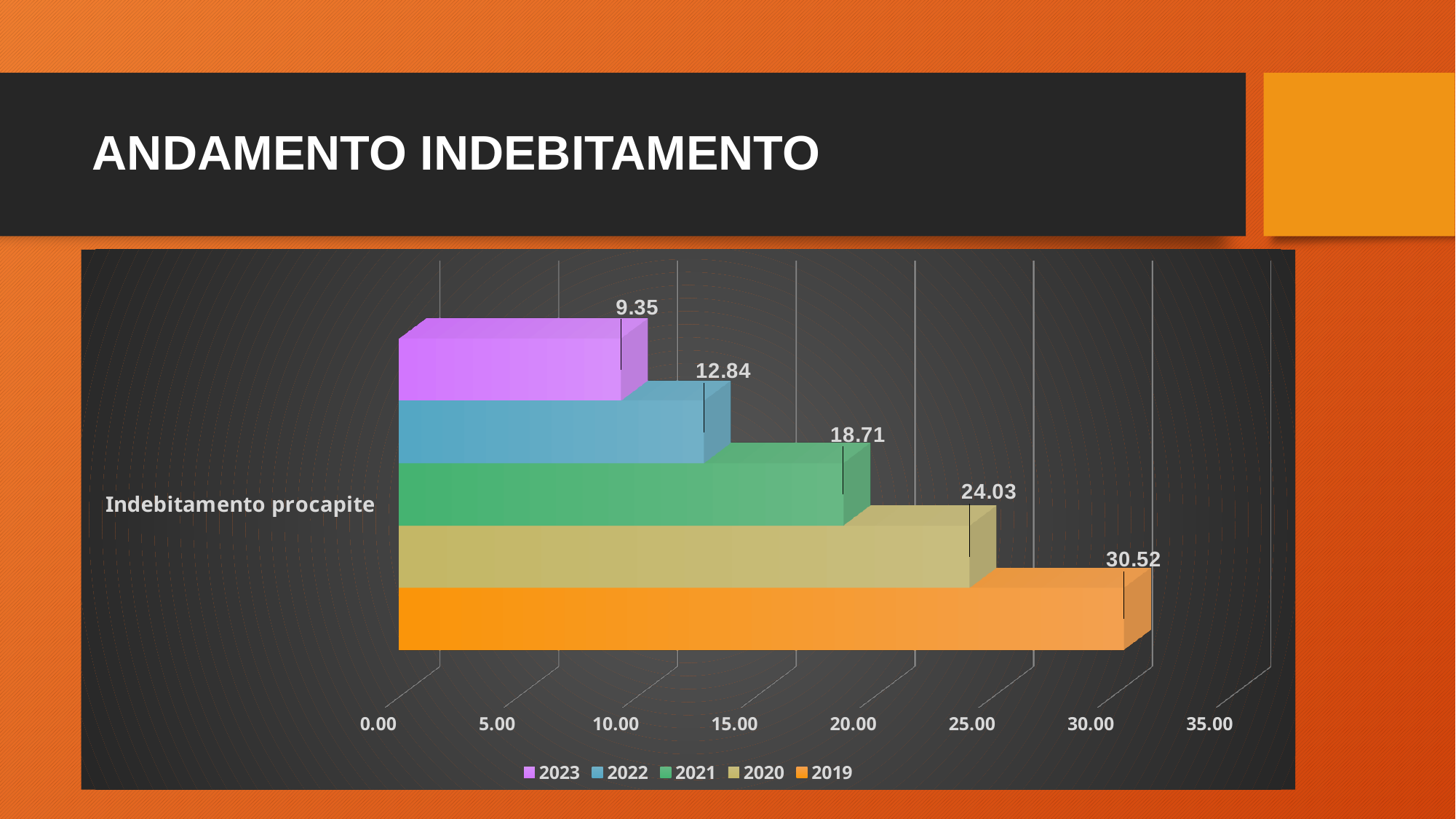
Which year has the lowest value in the chart? 2023 What is the category label shown on the chart's vertical axis? Indebitamento procapite What kind of chart is shown on the slide? bar chart What is the value for 2021 in the chart? 18.71 How many series does the legend list? 5 Which is larger, the value for 2022 or the value for 2021? 2021 Is the value for 2020 greater or less than 25.00? less What is the difference between the values for 2020 and 2022? 11.19 What is the difference between the values for 2019 and 2023? 21.17 What is the value for 2019 in the chart? 30.52 Which year has the highest value in the chart? 2019 What is the value for 2023 in the chart? 9.35